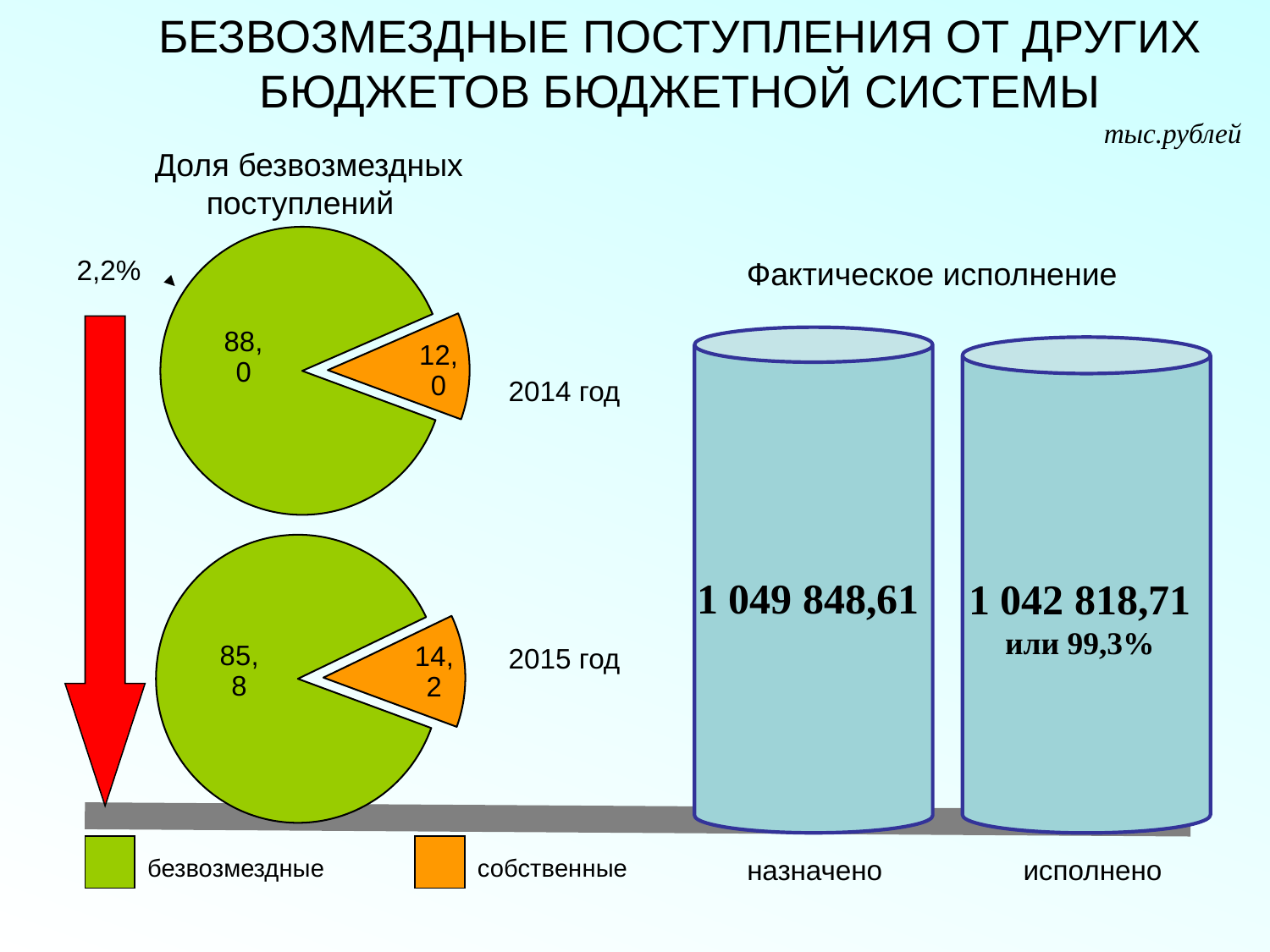
In the 2014 pie chart (Доля безвозмездных поступлений), what is the value for безвозмездные? 88,0 By how much did the безвозмездные share fall from the 2014 pie chart to the 2015 pie chart? 2,2 In the 2015 pie chart, which slice is larger: безвозмездные or собственные? безвозмездные In the 2015 pie chart, what is the value for безвозмездные? 85,8 In the 2014 pie chart, what is the value for собственные? 12,0 What kind of chart is used to show Доля безвозмездных поступлений for 2014 and 2015? pie chart In the Фактическое исполнение chart, what is the value for исполнено? 1 042 818,71 In the 2015 pie chart, what is the value for собственные? 14,2 In the Фактическое исполнение chart, what is the difference between назначено and исполнено? 7 029,90 How many series does the legend under the pie charts list? 2 In the Фактическое исполнение chart, what percentage of назначено does исполнено represent, as printed on the slide? 99,3% In the Фактическое исполнение chart, what is the value for назначено? 1 049 848,61